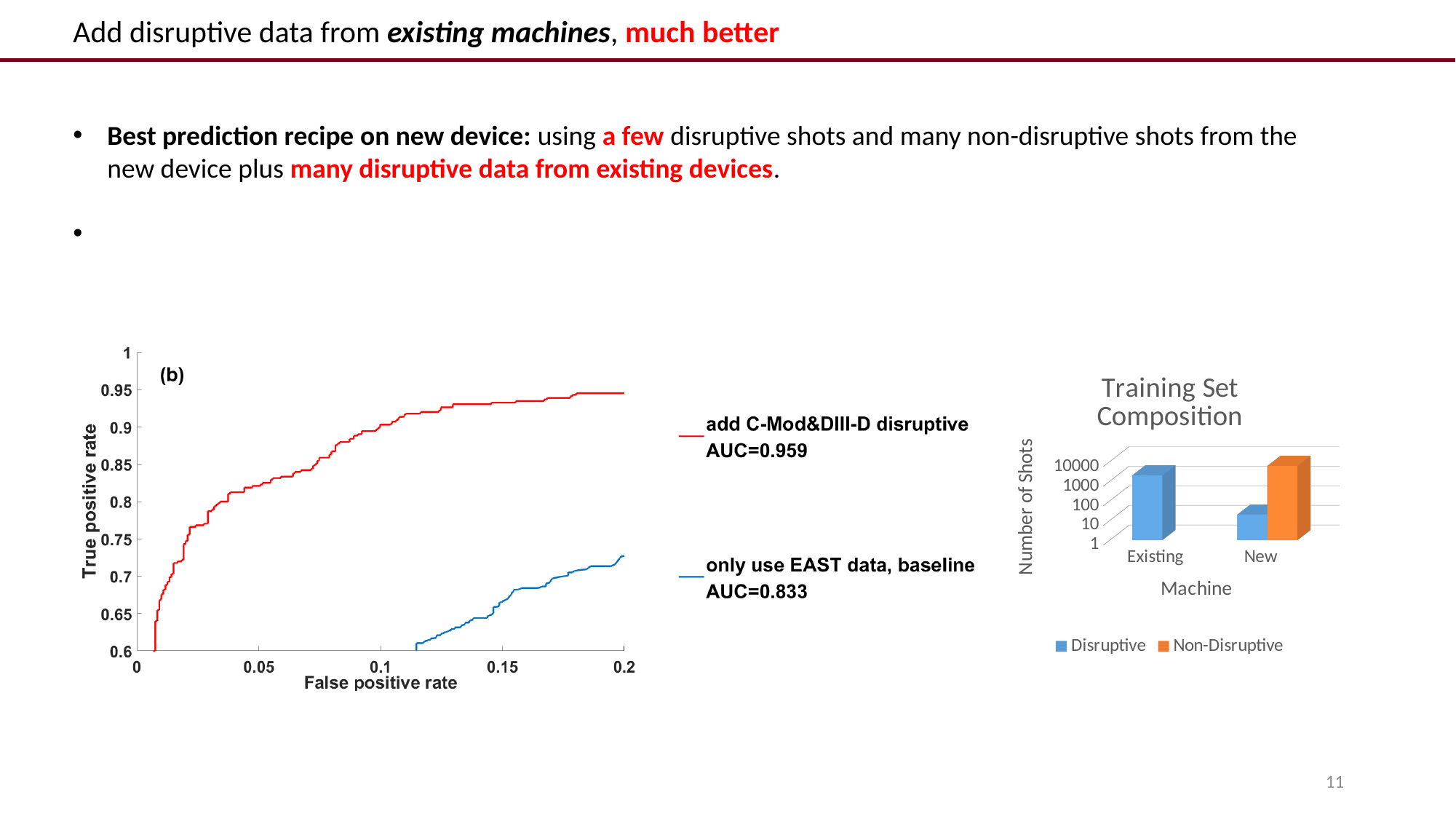
In the 'Training Set Composition' chart, for the New machine, which is larger: Disruptive or Non-Disruptive? Non-Disruptive In the ROC chart on the left, what is the AUC of the 'only use EAST data, baseline' curve? 0.833 In the 'Training Set Composition' chart, is the Disruptive value for New greater or less than 100? less In the 'Training Set Composition' chart, which machine has the larger Disruptive value, Existing or New? Existing In the ROC chart on the left, what is the difference between the two AUC values? 0.126 In the 'Training Set Composition' chart, is the Disruptive value for Existing greater or less than 1000? greater In the 'Training Set Composition' chart, how many series does the legend list? 2 In the ROC chart on the left, what is the AUC of the 'add C-Mod&DIII-D disruptive' curve? 0.959 In the 'Training Set Composition' chart, how many machine categories are shown on the x axis? 2 What kind of chart is the 'Training Set Composition' chart? bar chart In the 'Training Set Composition' chart, is the Non-Disruptive value for New greater or less than 1000? greater In the ROC chart on the left, what is the label of the x axis? False positive rate